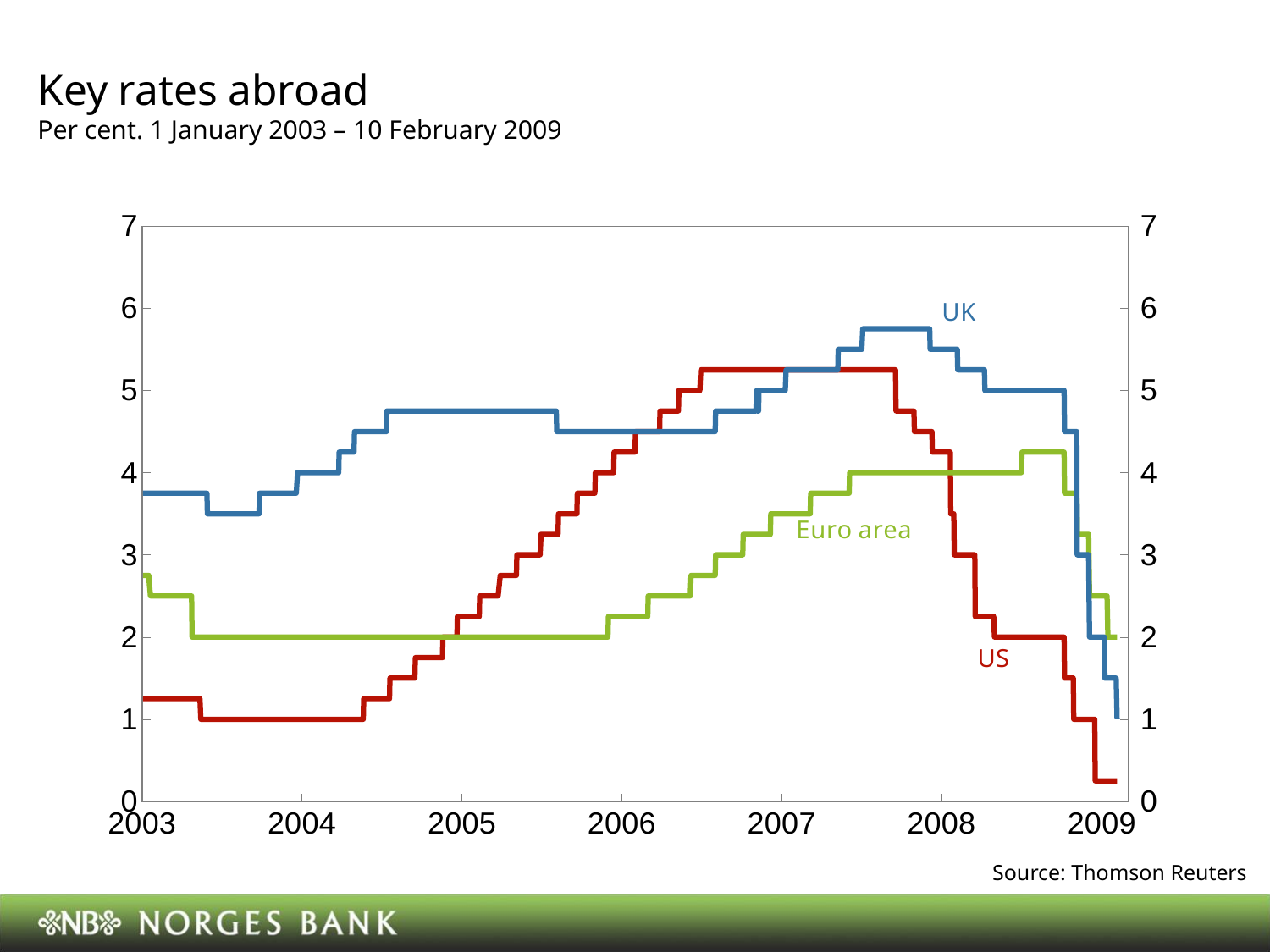
What was the UK key rate in mid-2008? 5 Which series had the highest key rate at the end of 2007? UK What kind of chart is shown on the slide? line chart Which series had the lowest key rate at the start of 2003? US Is the US key rate at the end of the period (February 2009) greater or less than 1? less Did the US key rate rise or fall between mid-2004 and mid-2006? rise What was the Euro area key rate during 2004? 2 What is the source given for the chart? Thomson Reuters Which series had the highest key rate at the start of 2003? UK How many series are plotted on the chart? 3 What was the US key rate during the second half of 2003? 1 What is the title of the chart? Key rates abroad